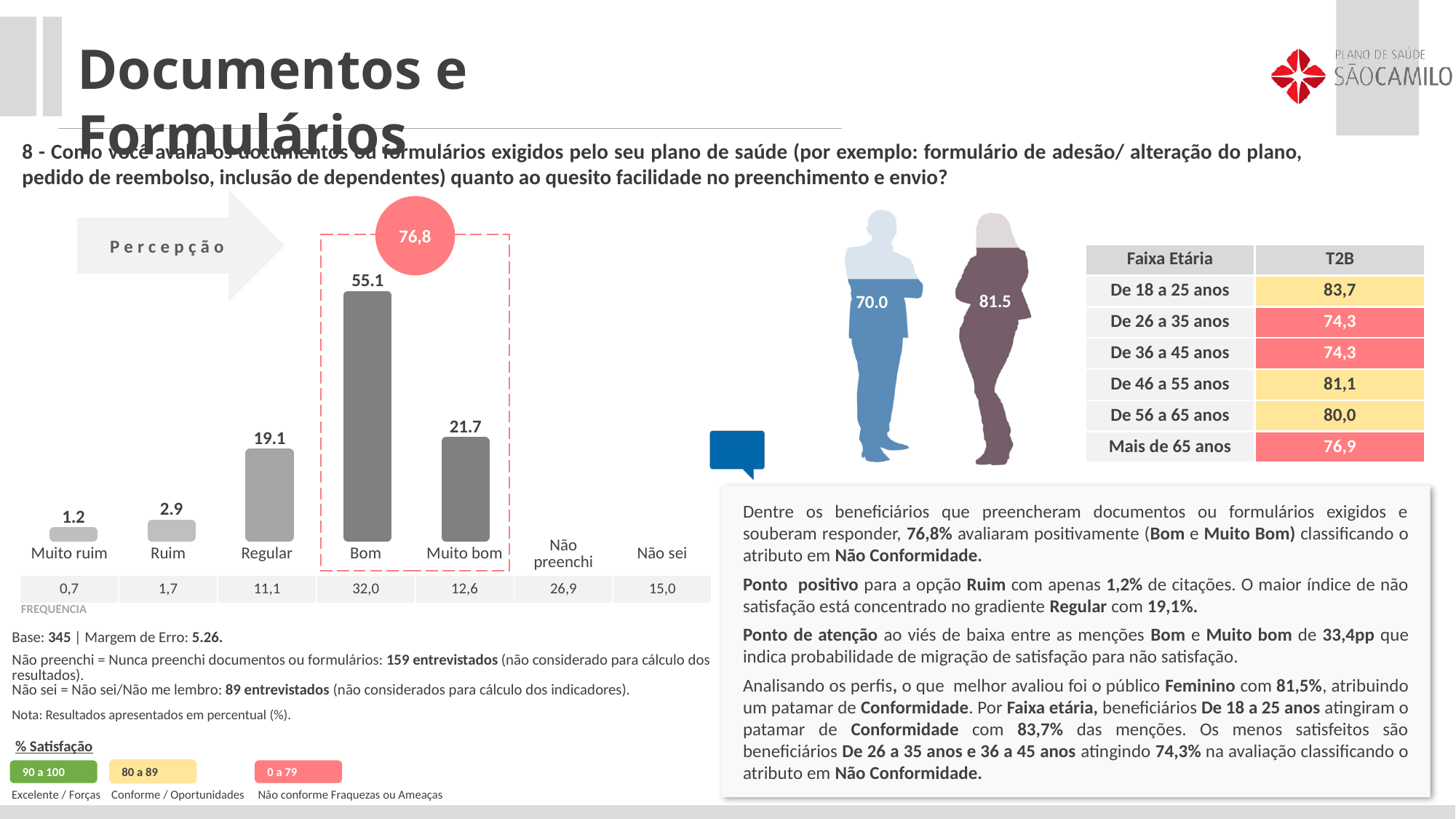
Which category has the highest bar in the bar chart? Bom In the Faixa Etária table, what is the T2B value for De 18 a 25 anos? 83,7 In the Faixa Etária table, which age group has the lowest T2B value? De 26 a 35 anos and De 36 a 45 anos (74,3) What is the difference between the Bom and Muito bom values in the bar chart? 33.4 What value is shown in the red circle above the dashed box around Bom and Muito bom? 76,8 Which is larger in the bar chart, Regular or Muito bom? Muito bom What is the value shown for the Muito ruim bar in the bar chart? 1.2 What is the value shown for the Bom bar in the bar chart? 55.1 What is the value shown for the Regular bar in the bar chart? 19.1 What type of chart is used to show the Percepção results? bar chart Which category with a plotted bar has the lowest value in the bar chart? Muito ruim What is the sum of the Ruim and Muito ruim values in the bar chart? 4.1